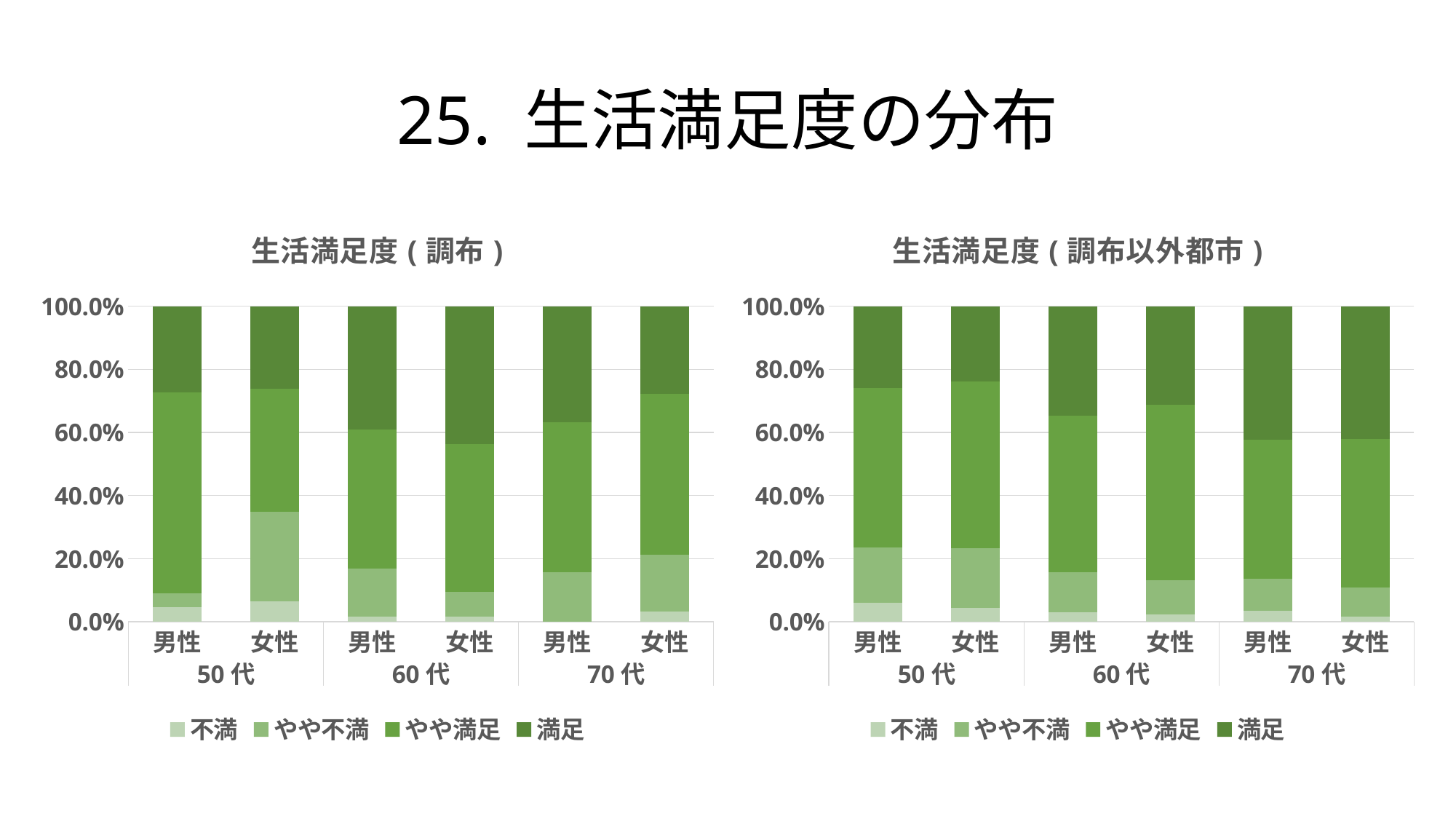
In the 生活満足度（調布以外都市） chart, is the 満足 share for 50代 女性 greater or less than 40%? less In the 生活満足度（調布） chart, which has the larger やや不満 share for 50代: 男性 or 女性? 女性 In the 生活満足度（調布） chart, which bar has the largest 満足 share? 60代 女性 In the 生活満足度（調布以外都市） chart, is the 満足 share for 70代 男性 greater or less than 20%? greater What kind of chart is the 生活満足度（調布） chart? Stacked bar chart How many bars are plotted in the 生活満足度（調布） chart? 6 What are the three age groups shown on the x axis of the 生活満足度（調布以外都市） chart? 50代, 60代, 70代 How many series does the legend of the 生活満足度（調布以外都市） chart list? 4 Which legend entry is drawn in the darkest green in the 生活満足度（調布） chart? 満足 In the 生活満足度（調布以外都市） chart, which has the larger 満足 share: 50代 男性 or 70代 男性? 70代 男性 In the 生活満足度（調布） chart, is the 満足 share for 50代 男性 greater or less than 40%? less